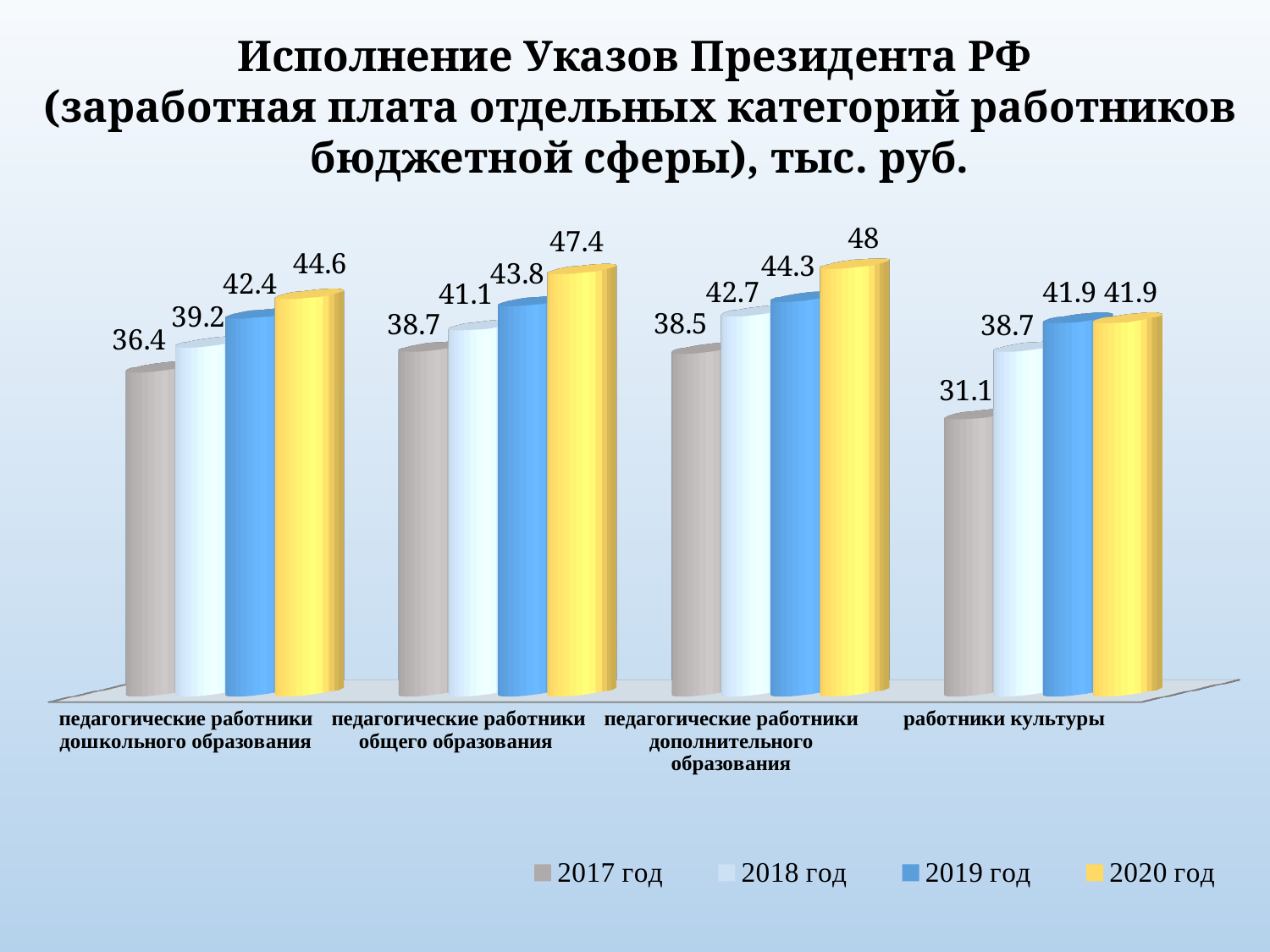
Which category has the highest value in 2020 год? педагогические работники дополнительного образования Which category has the lowest value in 2017 год? работники культуры What is the difference between the 2020 год and 2017 год values for работники культуры? 10.8 What is the value for работники культуры in 2020 год? 41.9 What kind of chart is shown on the slide? bar chart What is the difference between the 2020 год values for педагогические работники общего образования and педагогические работники дошкольного образования? 2.8 How many series does the legend list? 4 How many categories are shown on the x axis? 4 Which is larger: the 2018 год value for педагогические работники общего образования or for педагогические работники дополнительного образования? педагогические работники дополнительного образования What is the value for педагогические работники дошкольного образования in 2017 год? 36.4 What is the value for педагогические работники общего образования in 2019 год? 43.8 Do the values for педагогические работники общего образования rise or fall from 2017 год to 2020 год? rise